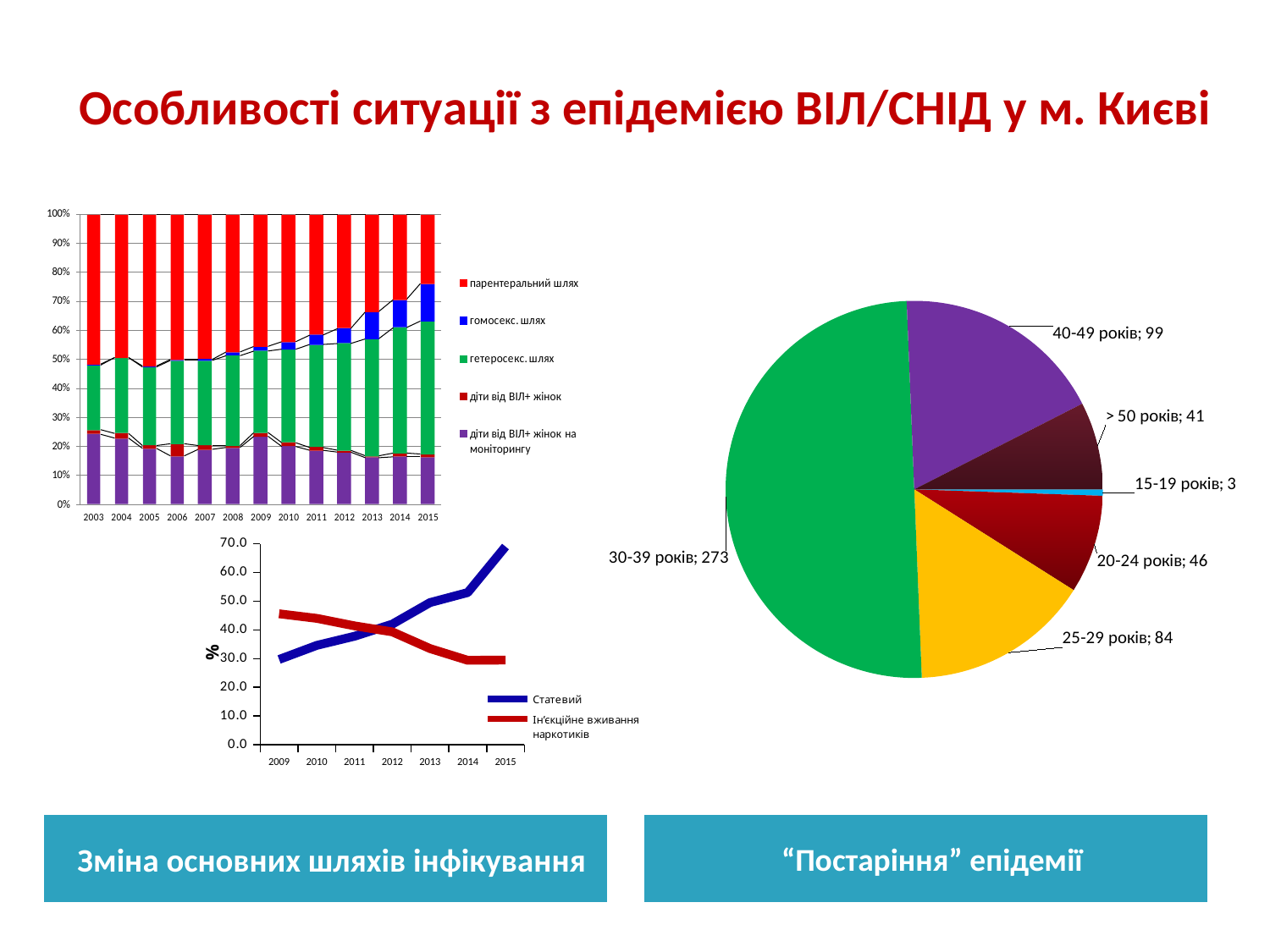
In the line chart at the bottom left, is the value for Статевий in 2015 greater or less than 60.0? greater In the pie chart on the right, which age group has the largest slice? 30-39 років In the stacked chart at the top left, how many years are shown on the x axis? 13 In the pie chart on the right, which age group has the smallest slice? 15-19 років In the pie chart on the right, which is larger: the value for 20-24 років or the value for > 50 років? 20-24 років In the pie chart on the right, how many slices are there? 6 In the pie chart on the right, what share of the total does the 30-39 років slice represent? 50% In the stacked chart at the top left, how many series does the legend list? 5 In the pie chart on the right, what is the value for the 25-29 років slice? 84 In the line chart at the bottom left, does the Статевий series rise or fall from 2009 to 2015? rise In the pie chart on the right, what is the difference between the values for 40-49 років and > 50 років? 58 In the pie chart on the right, what is the value for the 30-39 років slice? 273